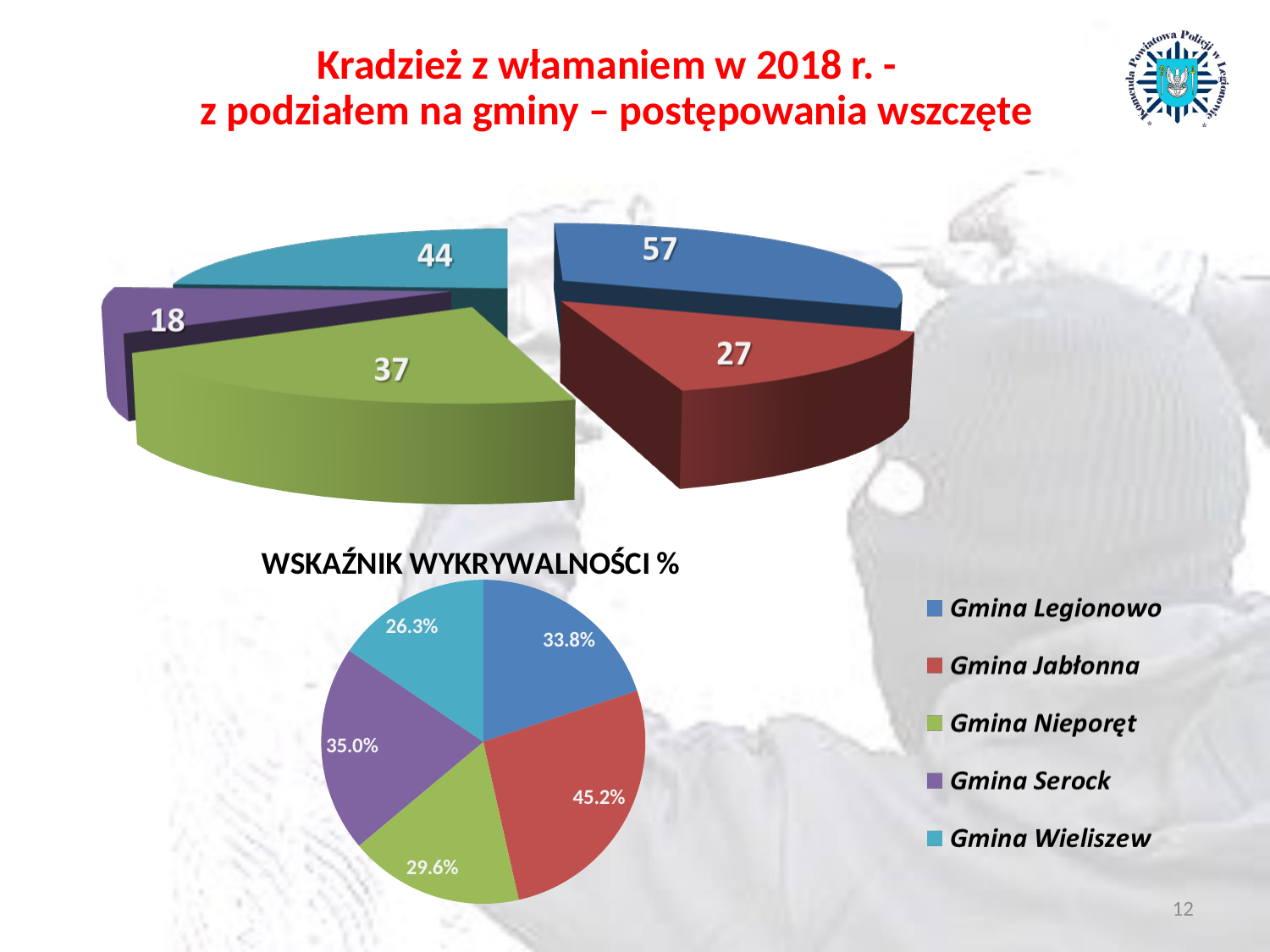
In the top pie chart, what is the value for Gmina Legionowo? 57 In the top pie chart, which gmina has the lowest value? Gmina Serock In the chart titled WSKAŹNIK WYKRYWALNOŚCI %, what is the difference between the values for Gmina Serock and Gmina Nieporęt? 5.4% In the chart titled WSKAŹNIK WYKRYWALNOŚCI %, which gmina has the lowest value? Gmina Wieliszew In the chart titled WSKAŹNIK WYKRYWALNOŚCI %, what is the value for Gmina Jabłonna? 45.2% How many categories does the top pie chart show? 5 In the top pie chart, what is the value for Gmina Serock? 18 In the chart titled WSKAŹNIK WYKRYWALNOŚCI %, what is the value for Gmina Wieliszew? 26.3% What kind of chart is the chart titled WSKAŹNIK WYKRYWALNOŚCI %? Pie chart In the top pie chart, which gmina has the highest value? Gmina Legionowo In the top pie chart, which is larger: the value for Gmina Wieliszew or Gmina Nieporęt? Gmina Wieliszew In the top pie chart, what is the difference between the values for Gmina Legionowo and Gmina Jabłonna? 30